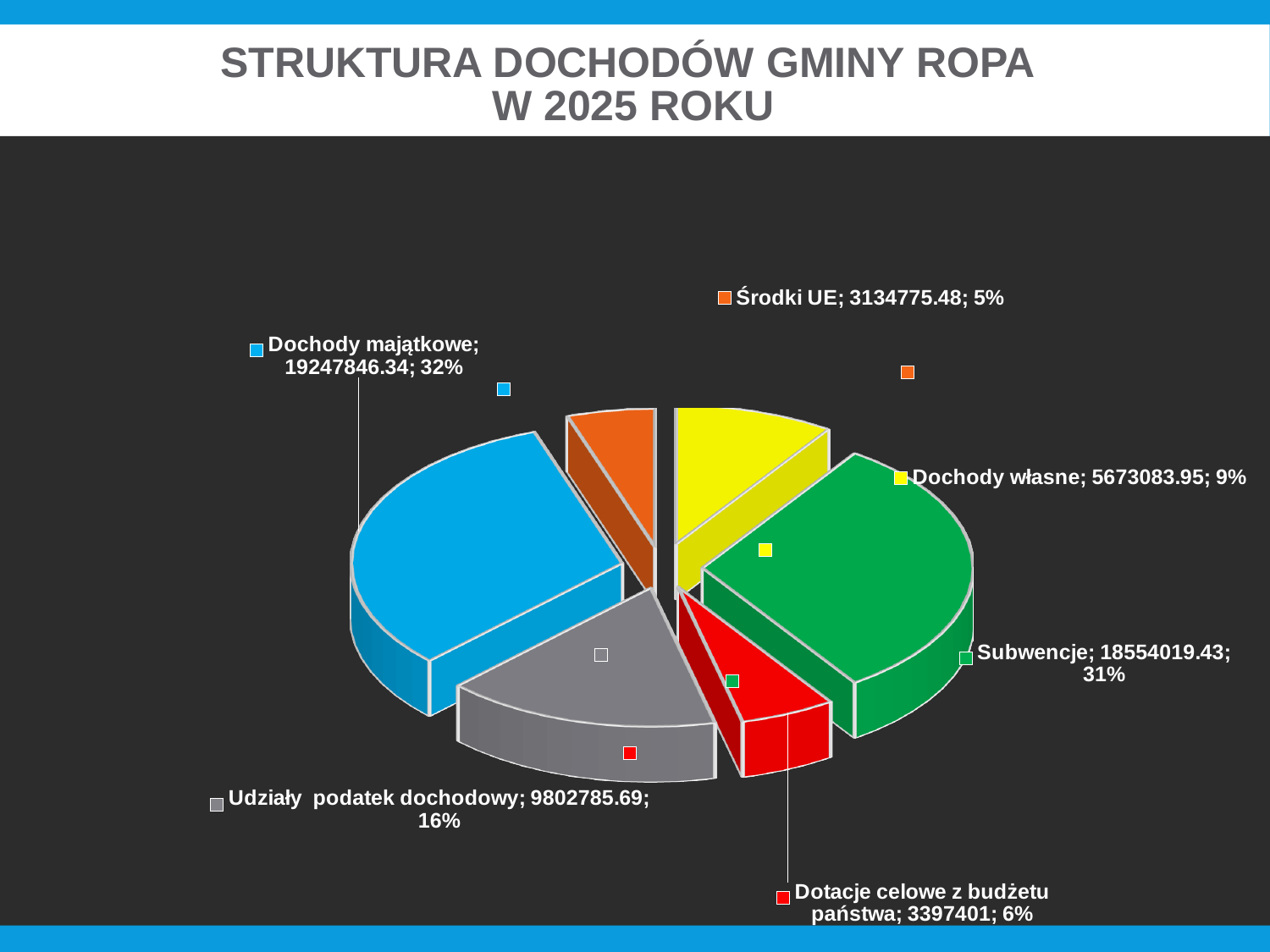
What is the value shown for Dochody majątkowe? 19247846.34 What percentage share does Dochody własne have in the pie chart? 9% What percentage share does Udziały podatek dochodowy have in the pie chart? 16% How many slices does the pie chart have? 6 Which category has the largest share of the pie chart? Dochody majątkowe Which category has the smallest share of the pie chart? Środki UE What kind of chart is shown on the slide? Pie chart What is the title of the chart on the slide? STRUKTURA DOCHODÓW GMINY ROPA W 2025 ROKU What is the value shown for Dotacje celowe z budżetu państwa? 3397401 Which is larger, the value for Środki UE or the value for Dotacje celowe z budżetu państwa? Dotacje celowe z budżetu państwa What is the difference between the values for Dochody majątkowe and Subwencje? 693826.91 What is the value shown for Subwencje? 18554019.43